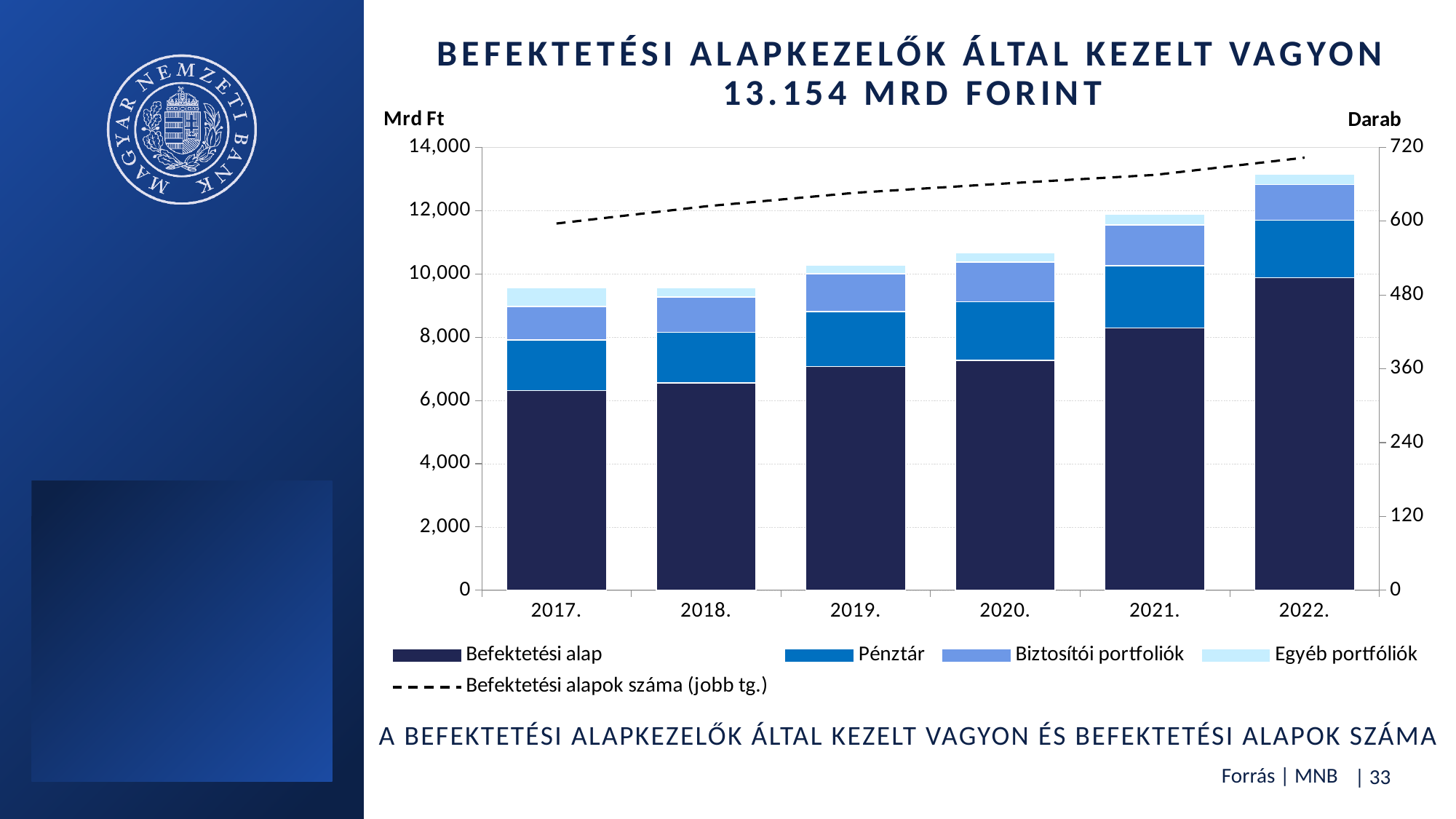
Is the total stacked bar for 2017. greater or less than 10,000? less Which is larger, the Befektetési alap value for 2021. or for 2020.? 2021. Is the Befektetési alapok száma (jobb tg.) value for 2022. greater or less than 600? greater Which year has the highest total stacked bar? 2022. Does the dashed line Befektetési alapok száma (jobb tg.) rise or fall from 2017. to 2022.? rise What is the label of the right-hand vertical axis? Darab Is the total stacked bar for 2022. greater or less than 12,000? greater What kind of chart is shown on the slide? Stacked bar chart with a line How many years are shown on the x axis of the chart? 6 How many series does the chart legend list? 5